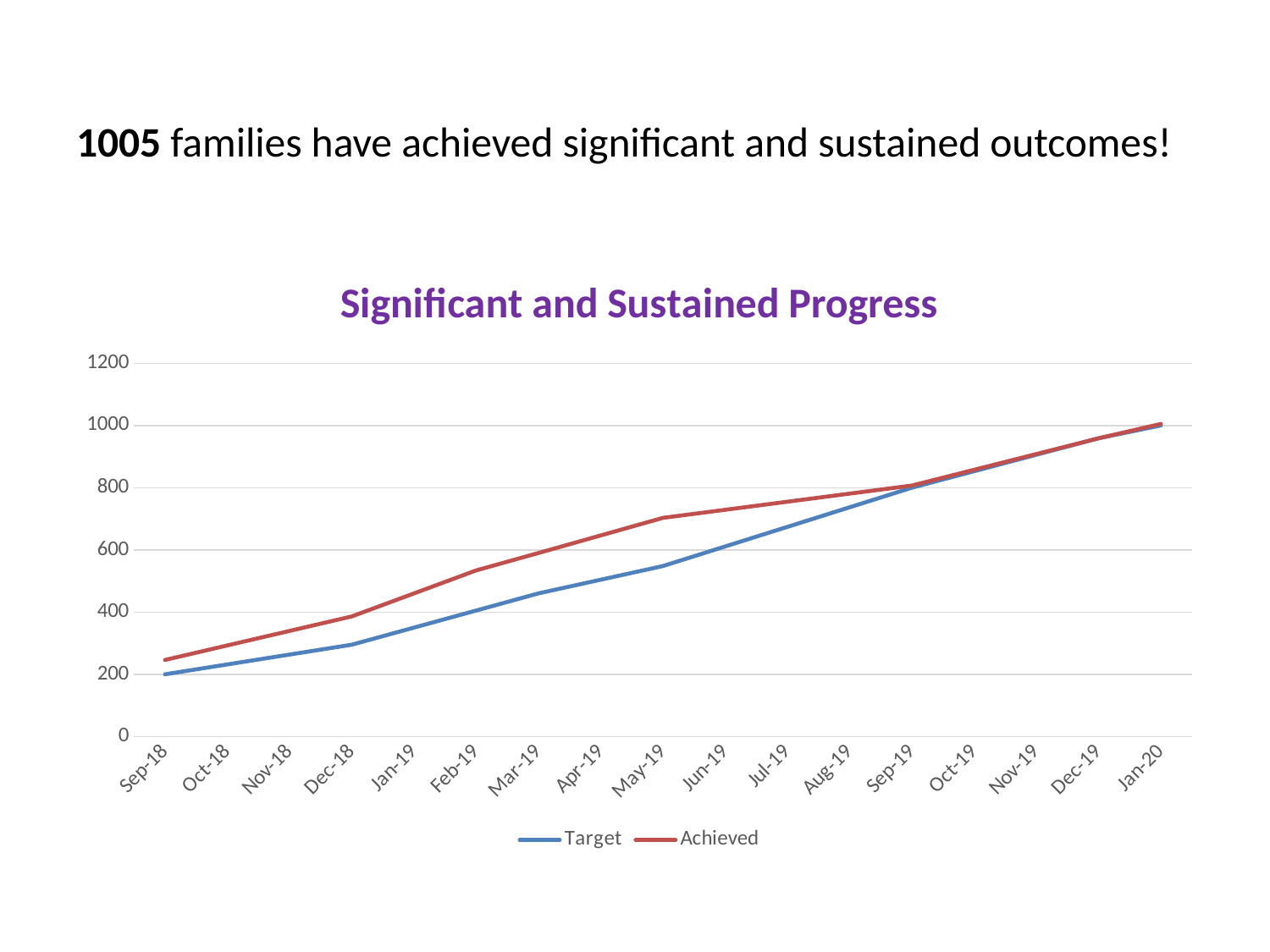
What is the title of the chart? Significant and Sustained Progress How many months are plotted along the x axis? 17 Which colour is used for the Achieved line? red Is the Achieved value for Jan-20 greater or less than 800? greater Is the Achieved value for May-19 greater or less than 600? greater Does the Target line rise or fall from Sep-18 to Jan-20? rise At Feb-19, which series has the larger value, Target or Achieved? Achieved What is the Target value for Sep-18? 200 Is the Target value for Sep-19 greater or less than 1000? less What kind of chart is shown on the slide? line chart How many series does the legend list? 2